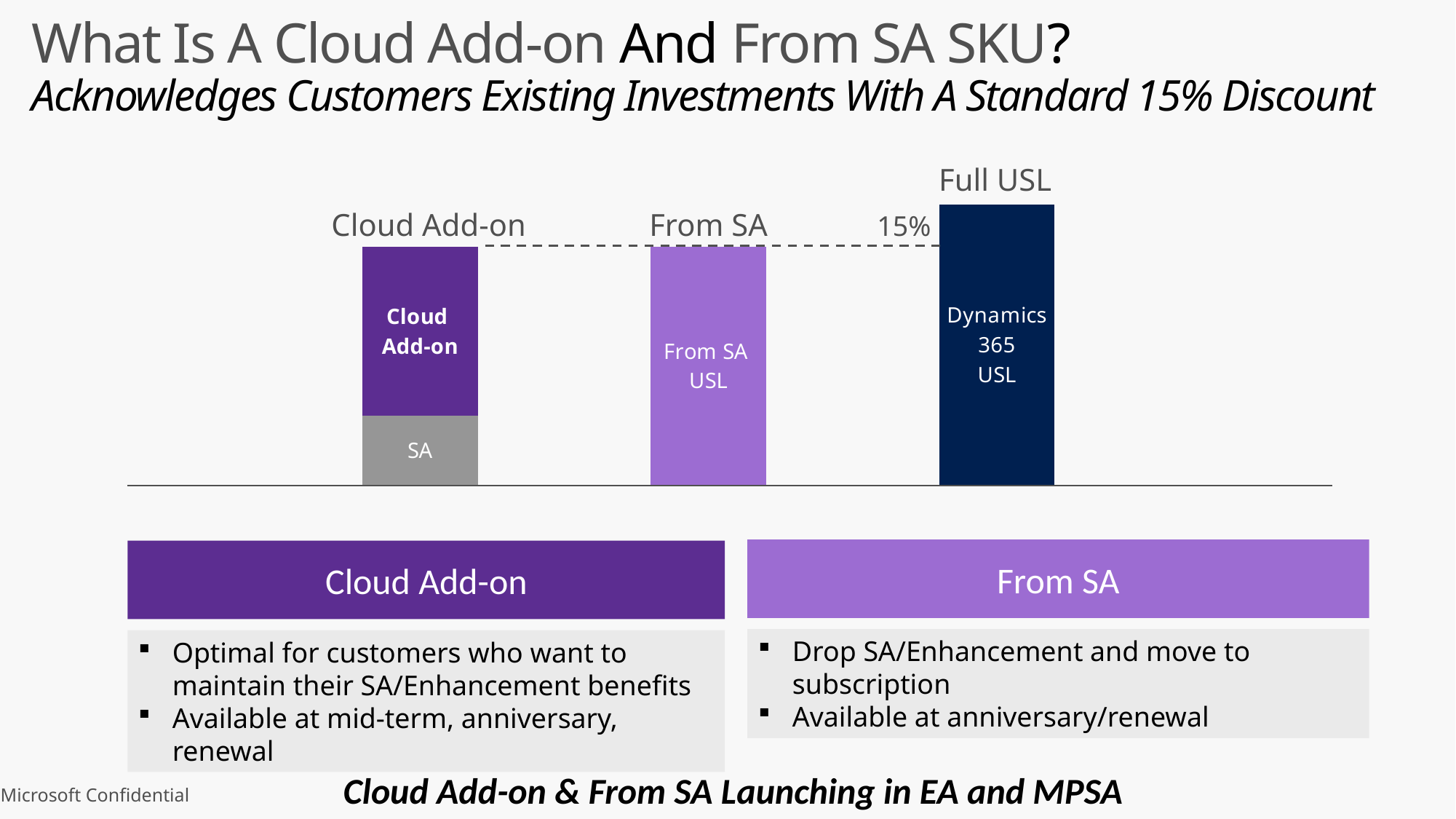
What are the labels of the three bars from left to right? Cloud Add-on, From SA, Full USL What percentage is printed next to the dashed line between the From SA bar and the Full USL bar? 15% Which bar in the chart is the tallest? Full USL Which is taller in the chart, the Cloud Add-on bar or the Full USL bar? Full USL How many bars are shown in the chart? 3 Which is taller in the chart, the From SA bar or the Full USL bar? Full USL How many segments make up the Cloud Add-on bar? 2 What is the label of the bottom (grey) segment of the Cloud Add-on bar? SA What label is printed inside the Full USL bar? Dynamics 365 USL What kind of chart is shown on the slide? Bar chart